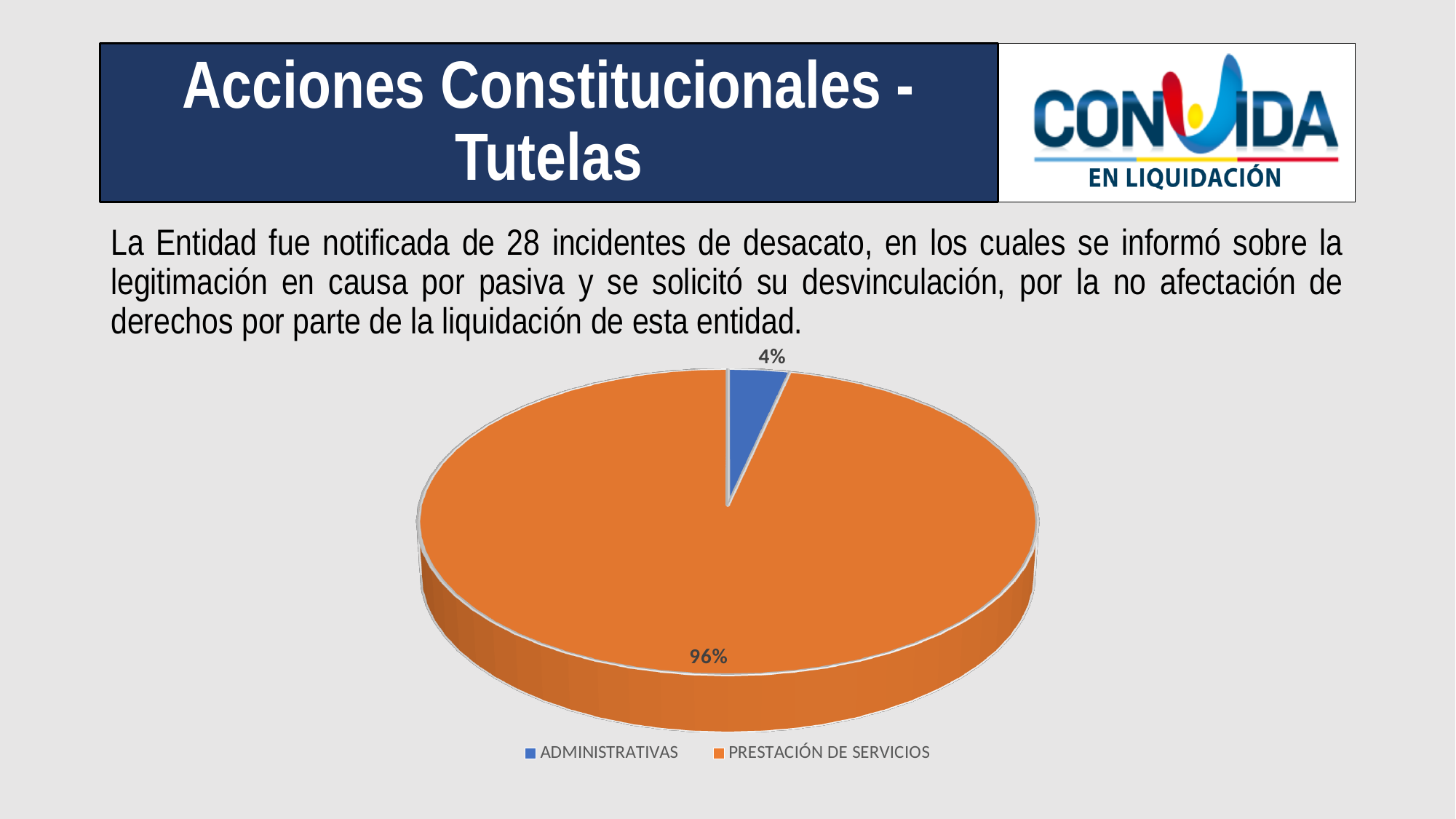
What kind of chart is shown on the slide? pie chart Which category has the largest slice of the pie? PRESTACIÓN DE SERVICIOS Which is larger, the share for ADMINISTRATIVAS or the share for PRESTACIÓN DE SERVICIOS? PRESTACIÓN DE SERVICIOS Which category has the smallest slice of the pie? ADMINISTRATIVAS How many categories does the pie chart show? 2 What colour is the ADMINISTRATIVAS slice? blue What share of the pie does ADMINISTRATIVAS represent? 4% What is the difference in percentage points between PRESTACIÓN DE SERVICIOS and ADMINISTRATIVAS? 92 How many entries does the legend list? 2 What colour is the PRESTACIÓN DE SERVICIOS slice? orange What share of the pie does PRESTACIÓN DE SERVICIOS represent? 96%